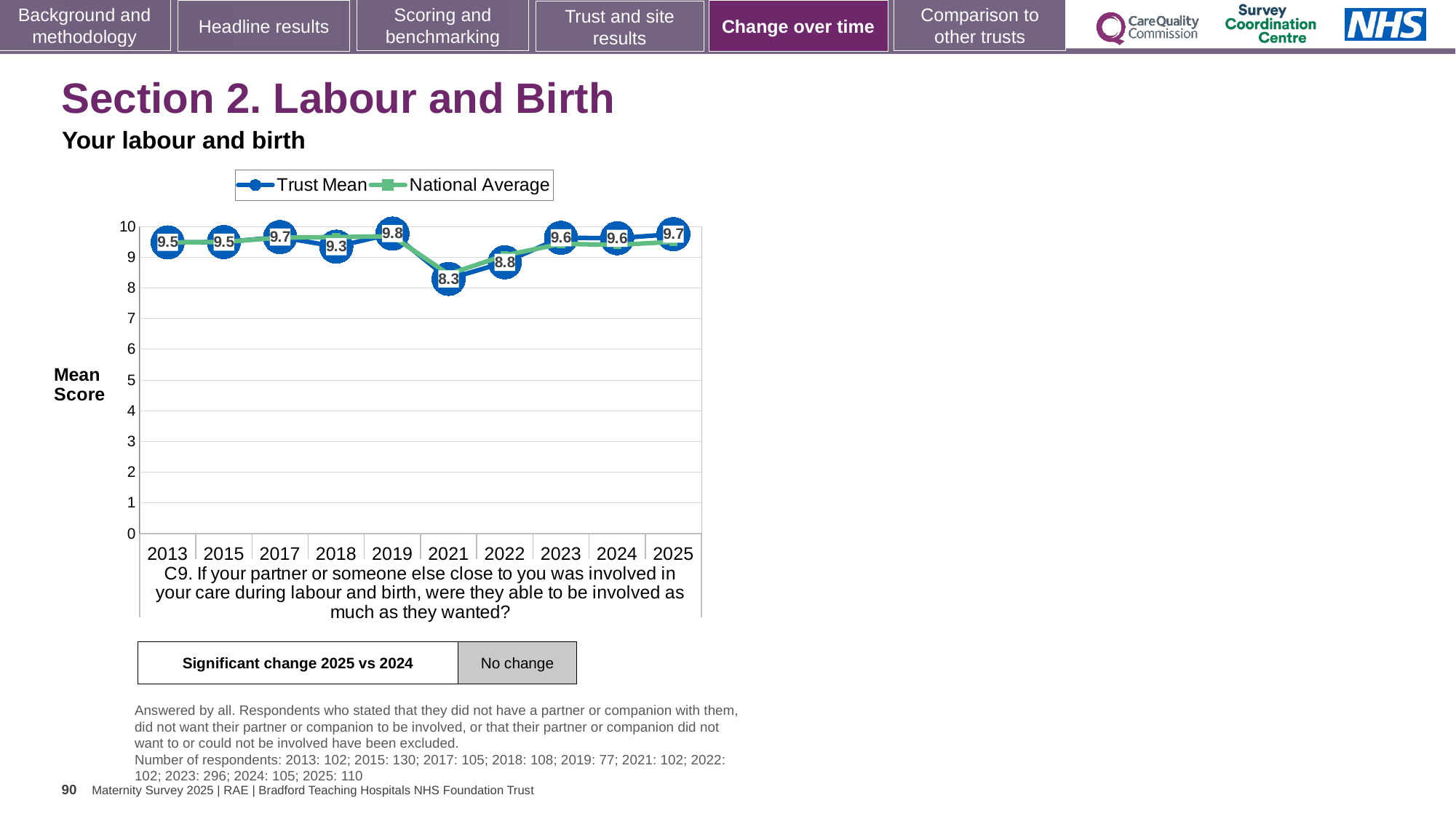
What kind of chart is shown? line chart How many series does the legend list? 2 Is the Trust Mean higher in 2022 or in 2023? 2023 What is the difference between the Trust Mean in 2019 and in 2021? 1.5 What is the Trust Mean for 2025? 9.7 What is the Trust Mean for 2021? 8.3 How many years are shown on the x axis? 10 What does the box labelled 'Significant change 2025 vs 2024' say? No change Which year has the lowest Trust Mean? 2021 What is the Trust Mean for 2019? 9.8 Is the Trust Mean for 2021 greater or less than 9? less Which year has the highest Trust Mean? 2019